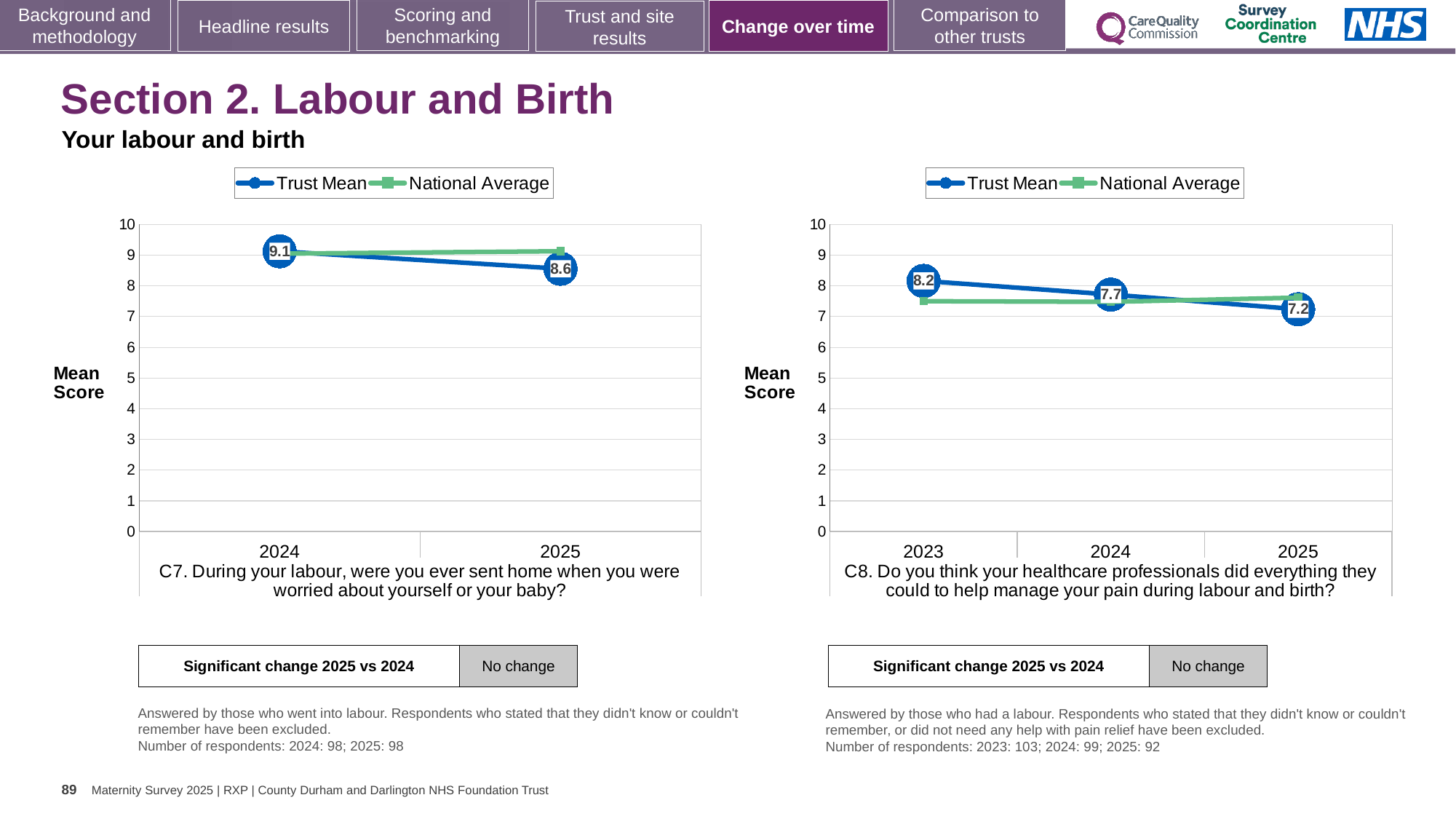
In the left chart (C7), what is the Trust Mean for 2024? 9.1 How many years are shown on the x axis of the right chart (C8)? 3 In the left chart (C7), what is the Trust Mean for 2025? 8.6 What kind of chart is the left chart (C7)? line chart In the right chart (C8), what is the difference between the Trust Mean in 2023 and in 2025? 1.0 In the right chart (C8), does the Trust Mean rise or fall from 2023 to 2025? fall How many series does the legend of the left chart (C7) list? 2 In the right chart (C8), what is the Trust Mean for 2025? 7.2 In the right chart (C8), what is the Trust Mean for 2023? 8.2 In the right chart (C8), is the National Average for 2023 greater or less than 8? less In the right chart (C8), which is larger in 2025, the Trust Mean or the National Average? National Average In the left chart (C7), by how much did the Trust Mean fall from 2024 to 2025? 0.5